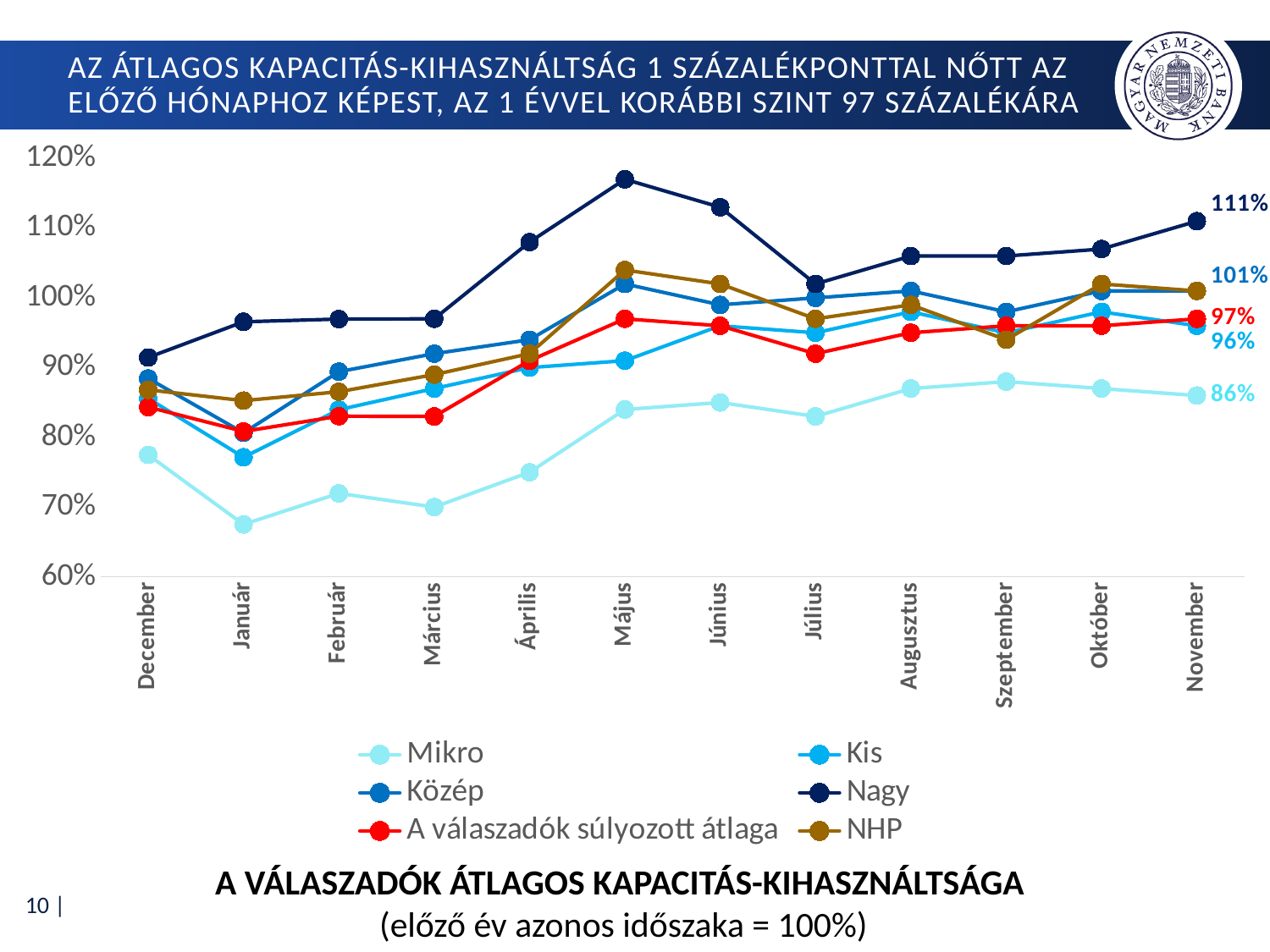
What type of chart is shown on the slide? line chart Is the value for Mikro in Január greater or less than 70%? less What is the value of the Mikro series in November? 86% What is the value of the Nagy series in November? 111% What is the value of the Kis series in November? 96% How many months are shown on the x axis? 12 What is the difference between the Nagy and Mikro values in November? 25 percentage points How many series does the legend list? 6 Is the value for Nagy in Május greater or less than 110%? greater What is the value of 'A válaszadók súlyozott átlaga' in November? 97% Which series has the lowest value in November? Mikro Which series has the highest value in November? Nagy